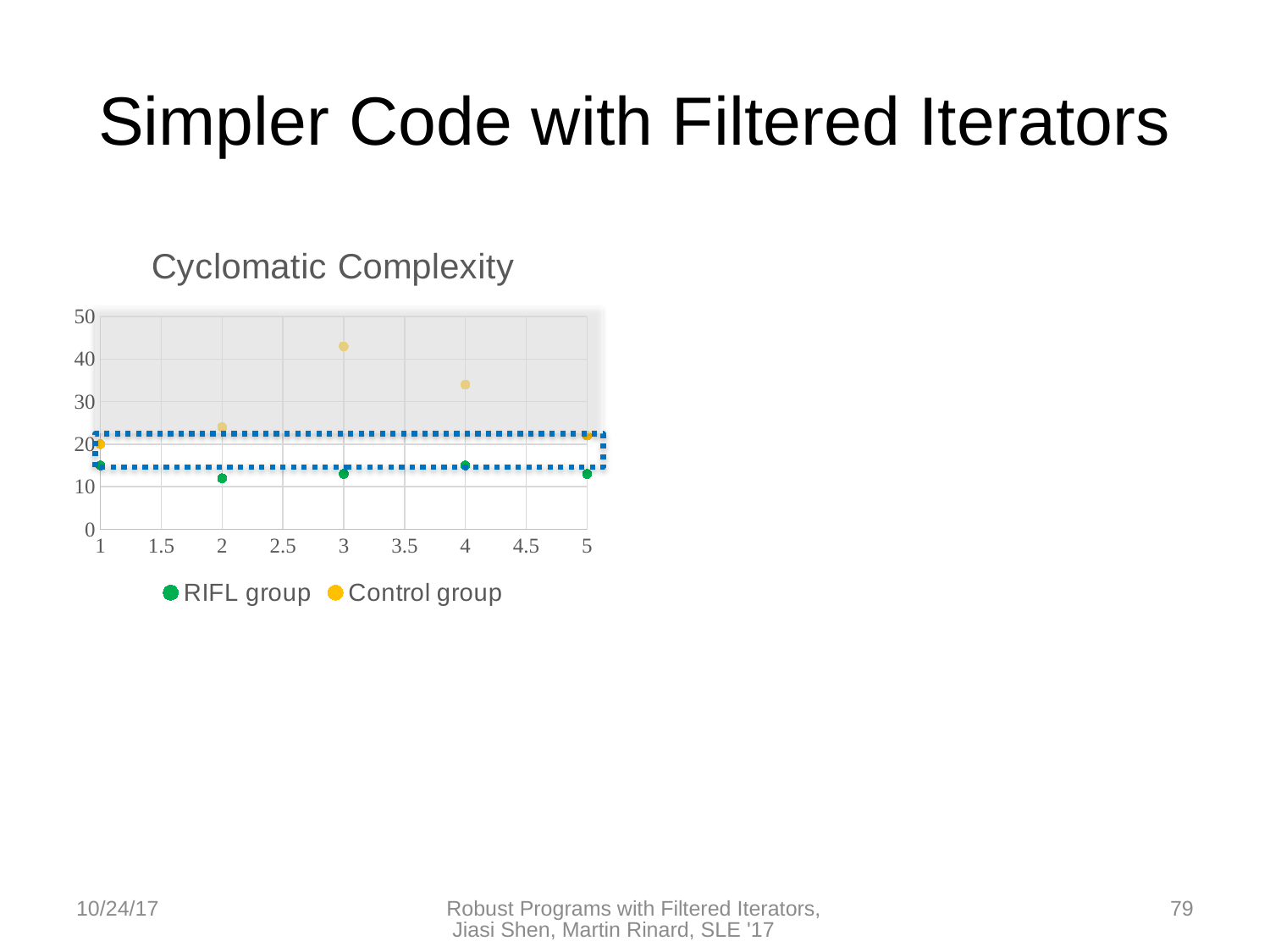
What kind of chart is shown on the slide? scatter chart Which two series are listed in the legend? RIFL group and Control group At which x value does the Control group reach its highest point? 3 Is the Control group value at x = 3 greater or less than 40? greater How many series does the legend list? 2 What is the title of the chart? Cyclomatic Complexity Which series has the lower values across all x positions? RIFL group At x = 3, which series has the larger value, RIFL group or Control group? Control group Are all RIFL group values below 20? yes How many points are plotted for the Control group? 5 Is the RIFL group value at x = 2 greater or less than 20? less